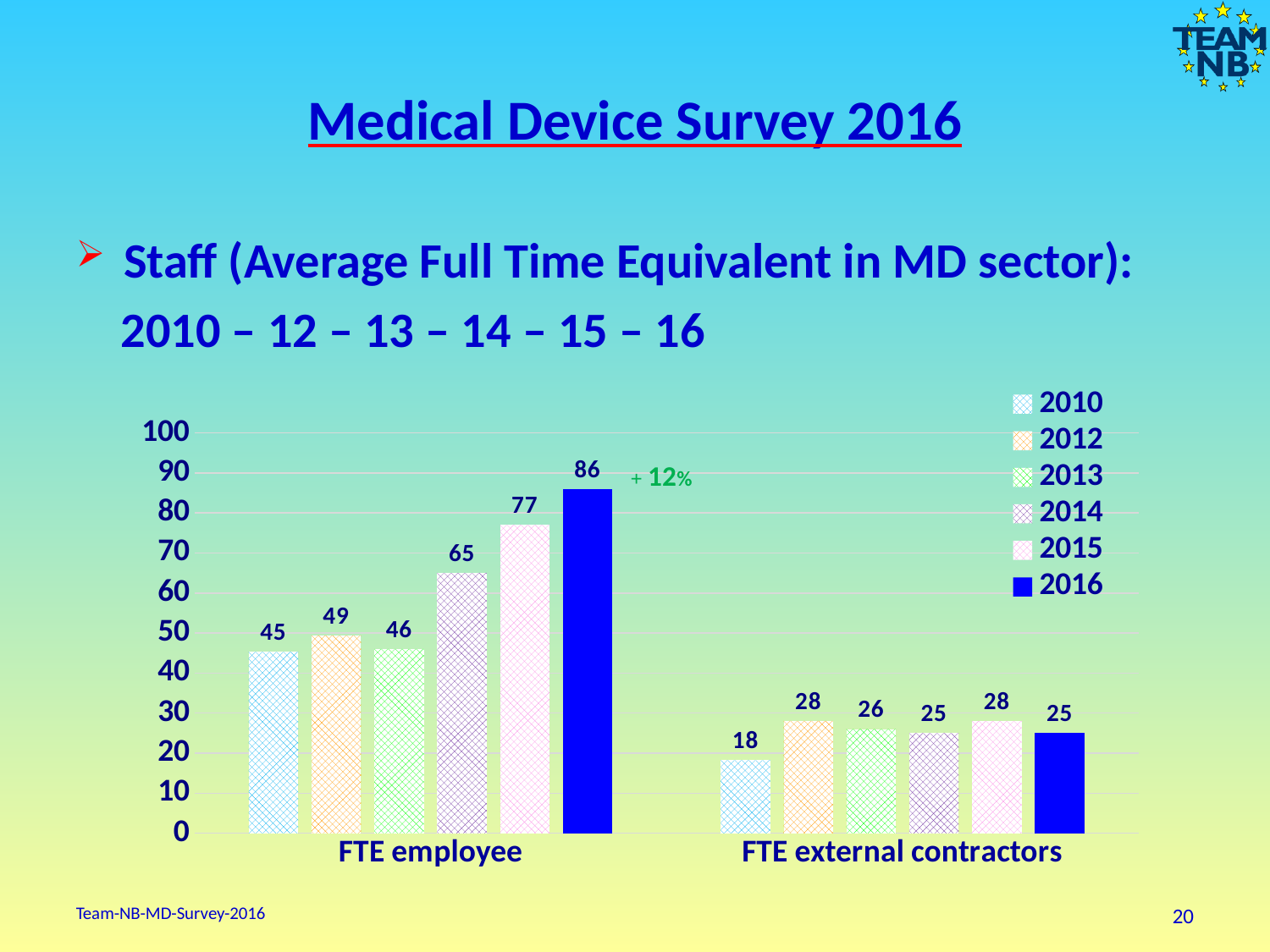
What is the value for 2016 in the FTE employee category? 86 What is the value for 2010 in the FTE external contractors category? 18 Which year has the lowest value in the FTE external contractors category? 2010 What percentage change is annotated next to the 2016 FTE employee bar? + 12% Is the value for 2015 in the FTE employee category greater or less than 70? greater What is the difference between the 2016 and 2015 values in the FTE employee category? 9 How many series does the legend list? 6 Which is larger in the FTE external contractors category: the value for 2012 or the value for 2013? 2012 How many categories are shown on the x axis? 2 What is the value for 2014 in the FTE employee category? 65 Which year has the highest value in the FTE employee category? 2016 What kind of chart is shown on the slide? bar chart